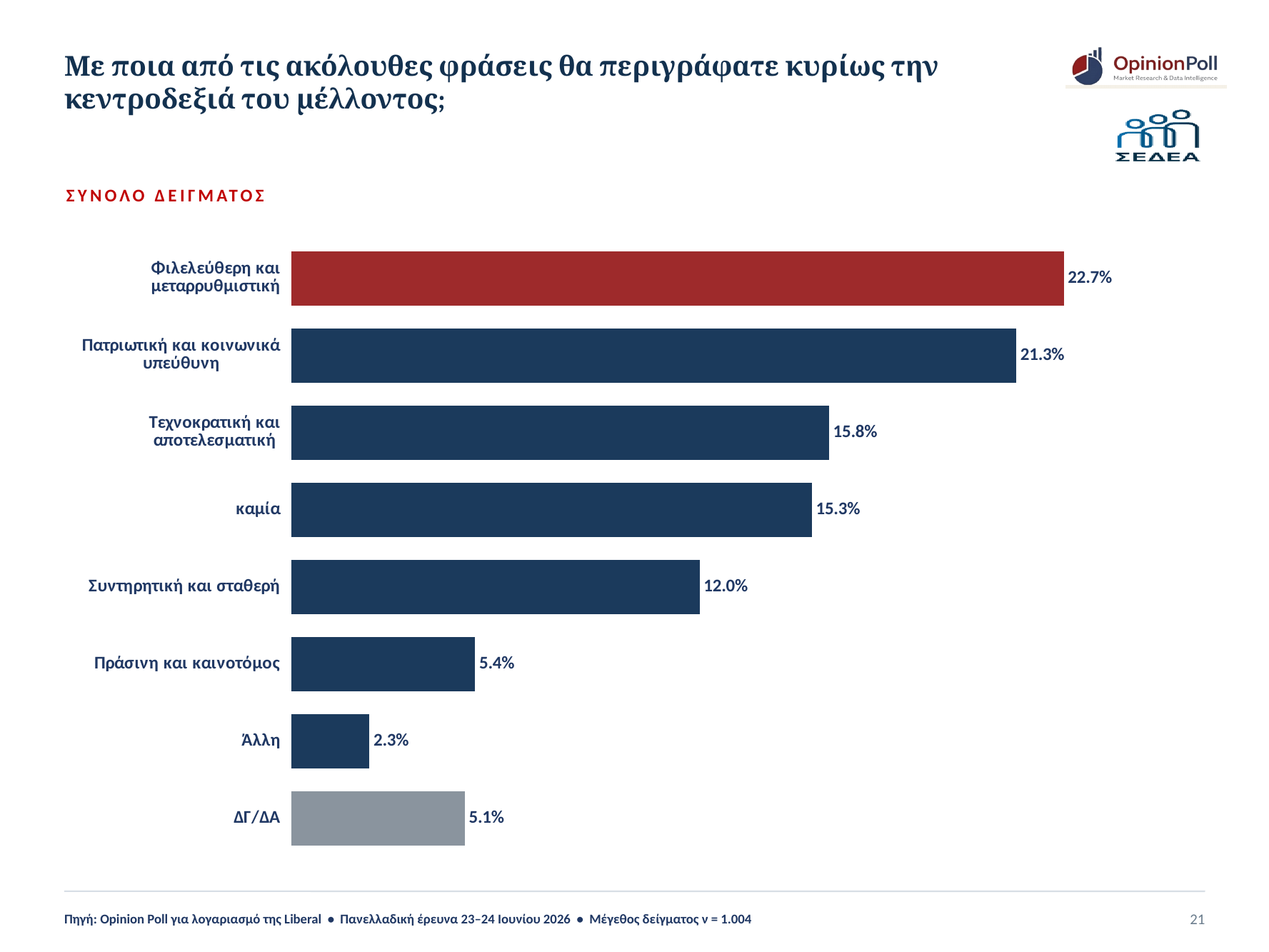
What is the value for "Πατριωτική και κοινωνικά υπεύθυνη"? 21.3% What is the difference between "Τεχνοκρατική και αποτελεσματική" and "Συντηρητική και σταθερή"? 3.8% What is the value for "Φιλελεύθερη και μεταρρυθμιστική"? 22.7% Which is larger, "Πράσινη και καινοτόμος" or "ΔΓ/ΔΑ"? Πράσινη και καινοτόμος What is the difference between "Φιλελεύθερη και μεταρρυθμιστική" and "Πατριωτική και κοινωνικά υπεύθυνη"? 1.4% What is the value for "καμία"? 15.3% What kind of chart is shown on the slide? Bar chart Which bar is coloured red? Φιλελεύθερη και μεταρρυθμιστική Which category has the highest value? Φιλελεύθερη και μεταρρυθμιστική Which category has the lowest value? Άλλη What is the value for "ΔΓ/ΔΑ"? 5.1% How many categories are shown in the chart? 8